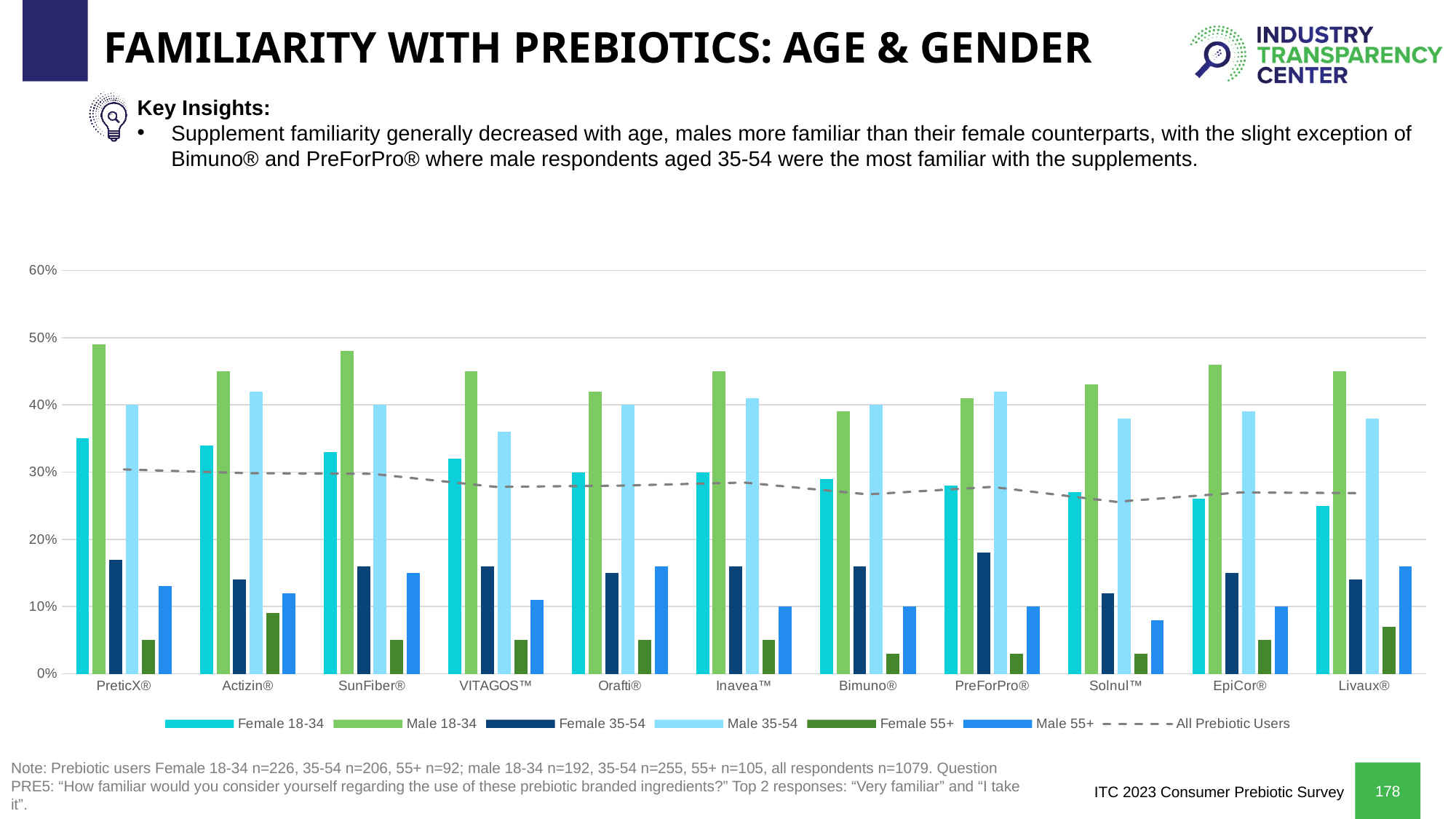
For Actizin®, which is larger: the Female 35-54 value or the Female 55+ value? Female 35-54 Which series has the lowest value for Inavea™? Female 55+ How many entries does the legend list? 7 Is the Female 55+ value for PreticX® greater or less than 10%? less Is the Female 18-34 value for Livaux® greater or less than 30%? less Is the Male 55+ value for Orafti® greater or less than 10%? greater What kind of chart is shown on the slide? Combination bar and line chart For PreticX®, which is larger: the Male 18-34 value or the Female 18-34 value? Male 18-34 How many prebiotic brands are shown along the x axis? 11 Do the Female 18-34 values generally rise or fall moving from PreticX® to Livaux® along the x axis? fall